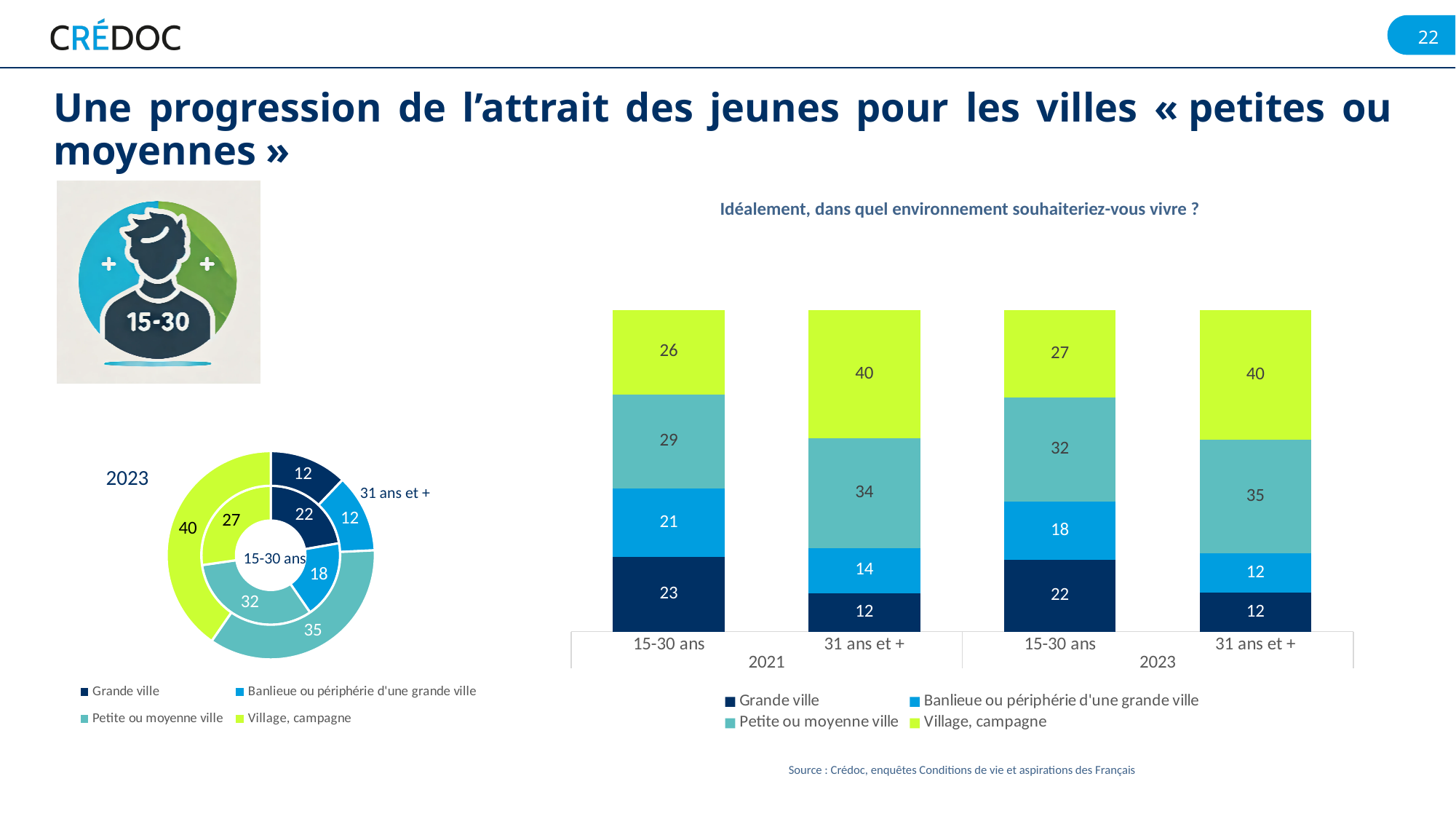
What is the title of the stacked bar chart on the right? Idéalement, dans quel environnement souhaiteriez-vous vivre ? In the stacked bar chart on the right, which segment is the smallest for 15-30 ans in 2023? Banlieue ou périphérie d'une grande ville In the stacked bar chart on the right, what is the total of the stacked bar for 31 ans et + in 2021? 100 In the doughnut chart on the left, what is the value for 'Village, campagne' in the 15-30 ans ring? 27 In the stacked bar chart on the right, what is the difference between the 'Petite ou moyenne ville' values for 15-30 ans in 2023 and in 2021? 3 In the stacked bar chart on the right, is the 'Banlieue ou périphérie d'une grande ville' value for 15-30 ans larger in 2021 or in 2023? 2021 In the stacked bar chart on the right, what is the value for 'Petite ou moyenne ville' for 15-30 ans in 2021? 29 In the stacked bar chart on the right, which segment is the largest for 31 ans et + in 2021? Village, campagne How many series does the legend of the stacked bar chart on the right list? 4 In the stacked bar chart on the right, what is the value for 'Grande ville' for 15-30 ans in 2023? 22 In the stacked bar chart on the right, what is the value for 'Village, campagne' for 31 ans et + in 2023? 40 What type of chart is the chart on the left labelled 2023? Doughnut chart